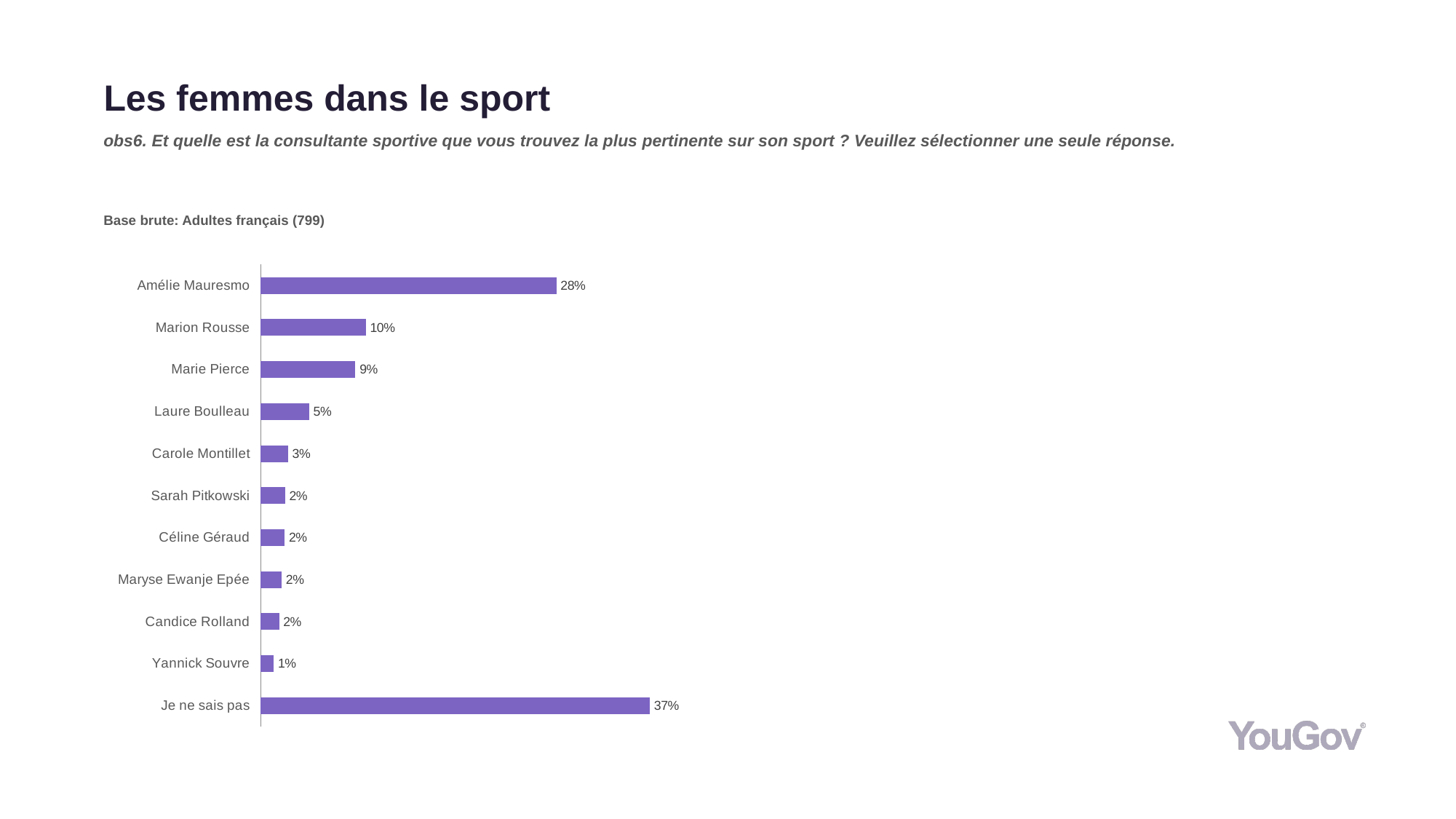
What is the difference between 'Je ne sais pas' and Amélie Mauresmo? 9 percentage points What percentage of respondents chose Amélie Mauresmo? 28% What kind of chart is shown on the slide? Bar chart What is the value for 'Je ne sais pas'? 37% What percentage is shown for Laure Boulleau? 5% How many categories are shown in the chart? 11 What is the value shown for Marion Rousse? 10% Which category has the highest value in the chart? Je ne sais pas Which category has the lowest value in the chart? Yannick Souvre What is the base (sample size) stated on the slide? Adultes français (799) Which has a larger value, Marie Pierce or Carole Montillet? Marie Pierce What is the difference between the values for Amélie Mauresmo and Marion Rousse? 18 percentage points